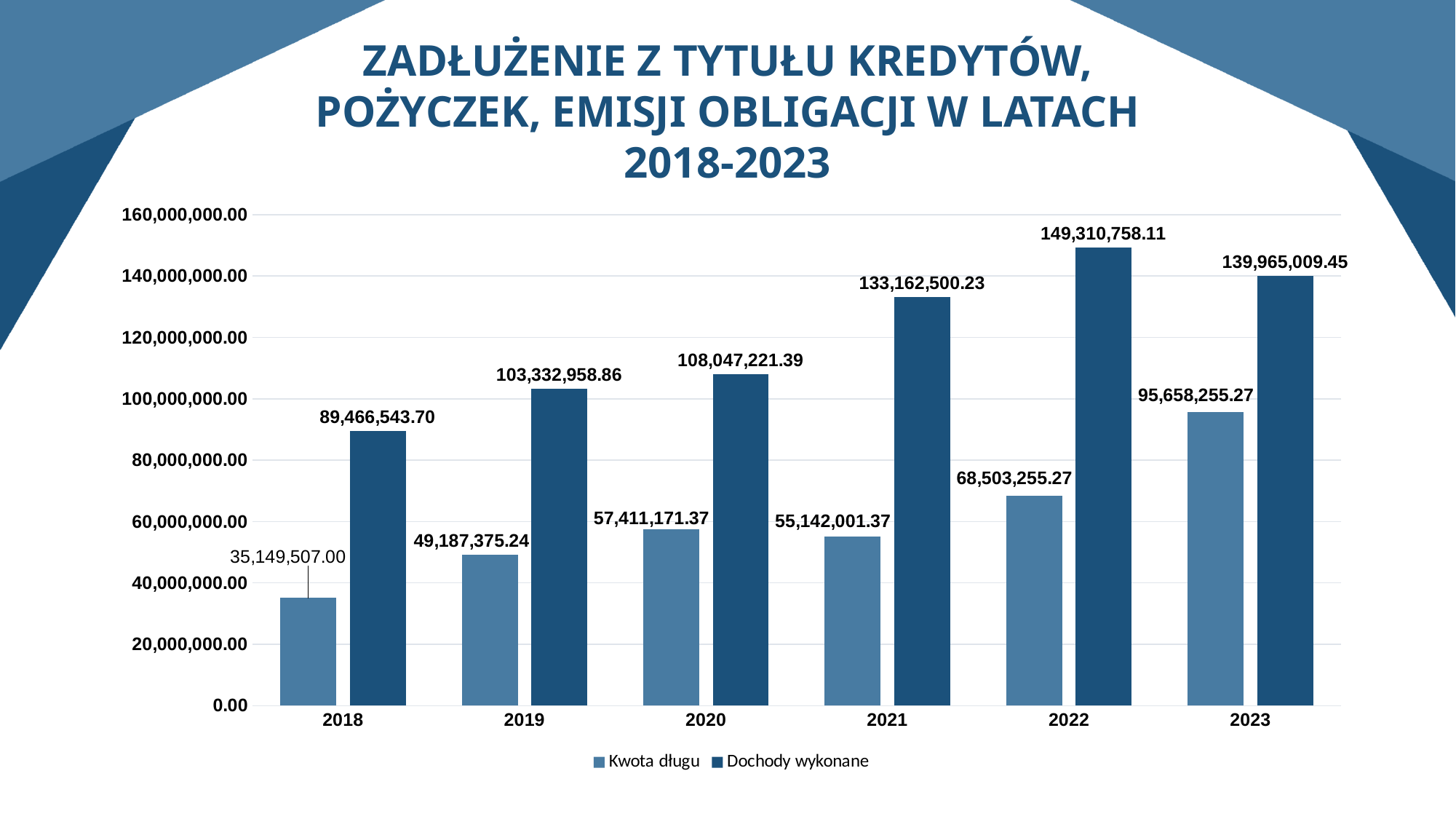
Is the value of Dochody wykonane for 2019 greater or less than 100,000,000.00? greater In which year is Kwota długu lowest? 2018 By how much did Dochody wykonane increase from 2021 to 2022? 16,148,257.88 How many years are shown on the x axis? 6 What is the value of Kwota długu for 2018? 35,149,507.00 How many series does the legend list? 2 What kind of chart is shown on the slide? bar chart In which year is Dochody wykonane highest? 2022 What is the difference between Dochody wykonane and Kwota długu in 2023? 44,306,754.18 What is the value of Dochody wykonane for 2021? 133,162,500.23 Which is larger: Kwota długu in 2020 or Kwota długu in 2021? 2020 What is the value of Kwota długu for 2023? 95,658,255.27